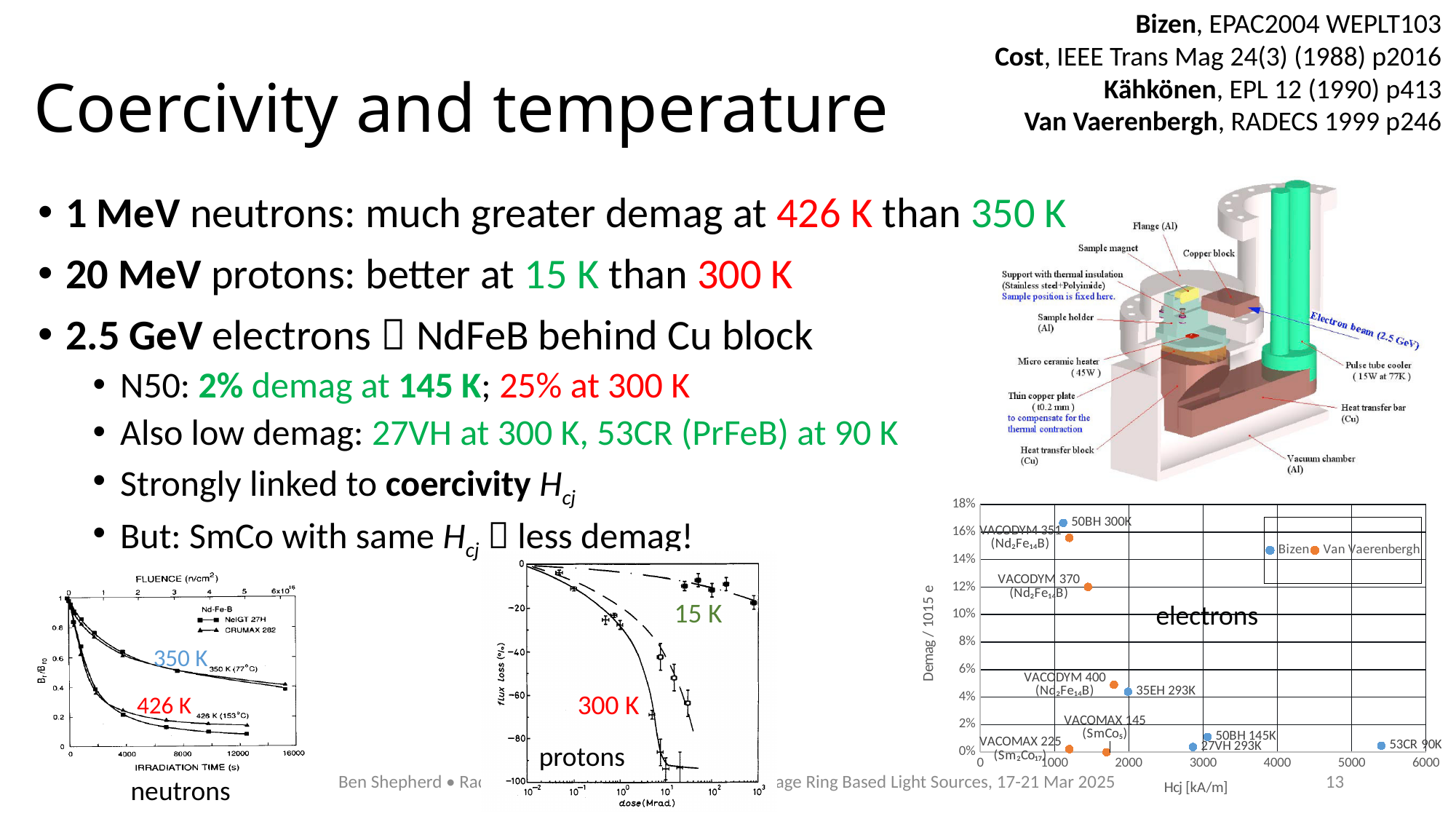
In the bottom-right electrons chart, is the demag value for 53CR 90K greater or less than 2%? less In the middle protons chart, which curve shows the greater flux loss at high dose, 15 K or 300 K? 300 K What are the two series named in the legend of the bottom-right electrons chart? Bizen and Van Vaerenbergh In the bottom-right electrons chart, is the demag value for 50BH 300K greater or less than 16%? greater In the bottom-right electrons chart, which has the larger demag value, 50BH 300K or 50BH 145K? 50BH 300K In the bottom-left neutrons chart, which curve shows the lower Br/Br0 values, 350 K or 426 K? 426 K In the bottom-right electrons chart, which point has the highest demag value? 50BH 300K In the bottom-left neutrons chart, does Br/Br0 rise or fall as irradiation time increases? fall What is the label of the horizontal axis of the bottom-right electrons chart? Hcj [kA/m] How many series does the legend of the bottom-right electrons chart list? 2 In the bottom-right electrons chart, is the demag value for VACODYM 370 greater or less than 14%? less